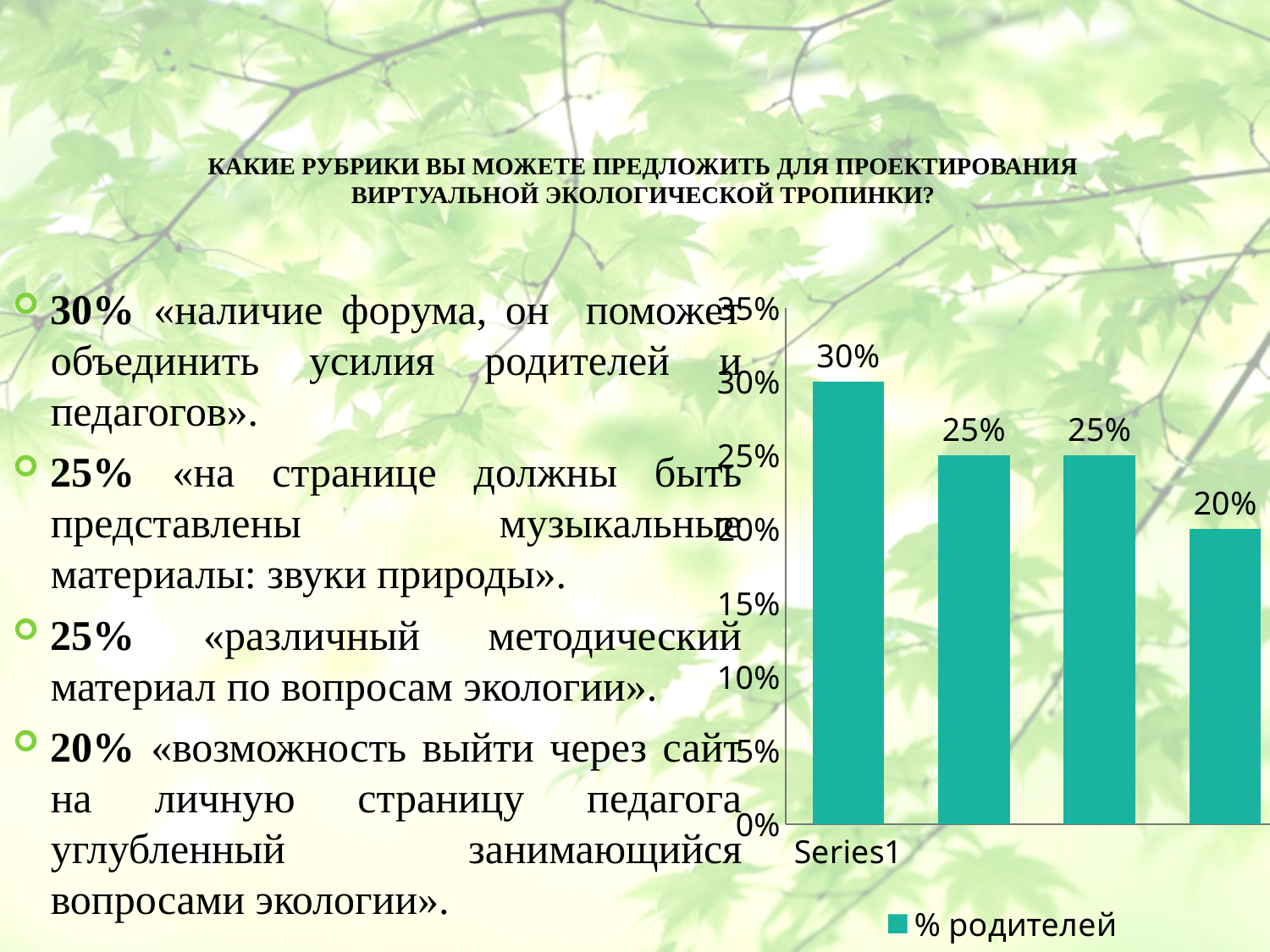
What is the value of the second bar in the chart? 25% How many series does the chart legend list? 1 How many bars are plotted in the chart? 4 What type of chart is shown on the slide? bar chart What is the legend entry of the chart? % родителей What is the highest value shown in the chart? 30% Which is larger, the first bar or the fourth bar? the first bar Do the bar values rise or fall from left to right across the chart? fall What is the difference between the first bar and the last bar in the chart? 10% What is the value of the first (leftmost) bar in the chart? 30% What is the lowest value shown in the chart? 20% What is the value of the last (rightmost) bar in the chart? 20%